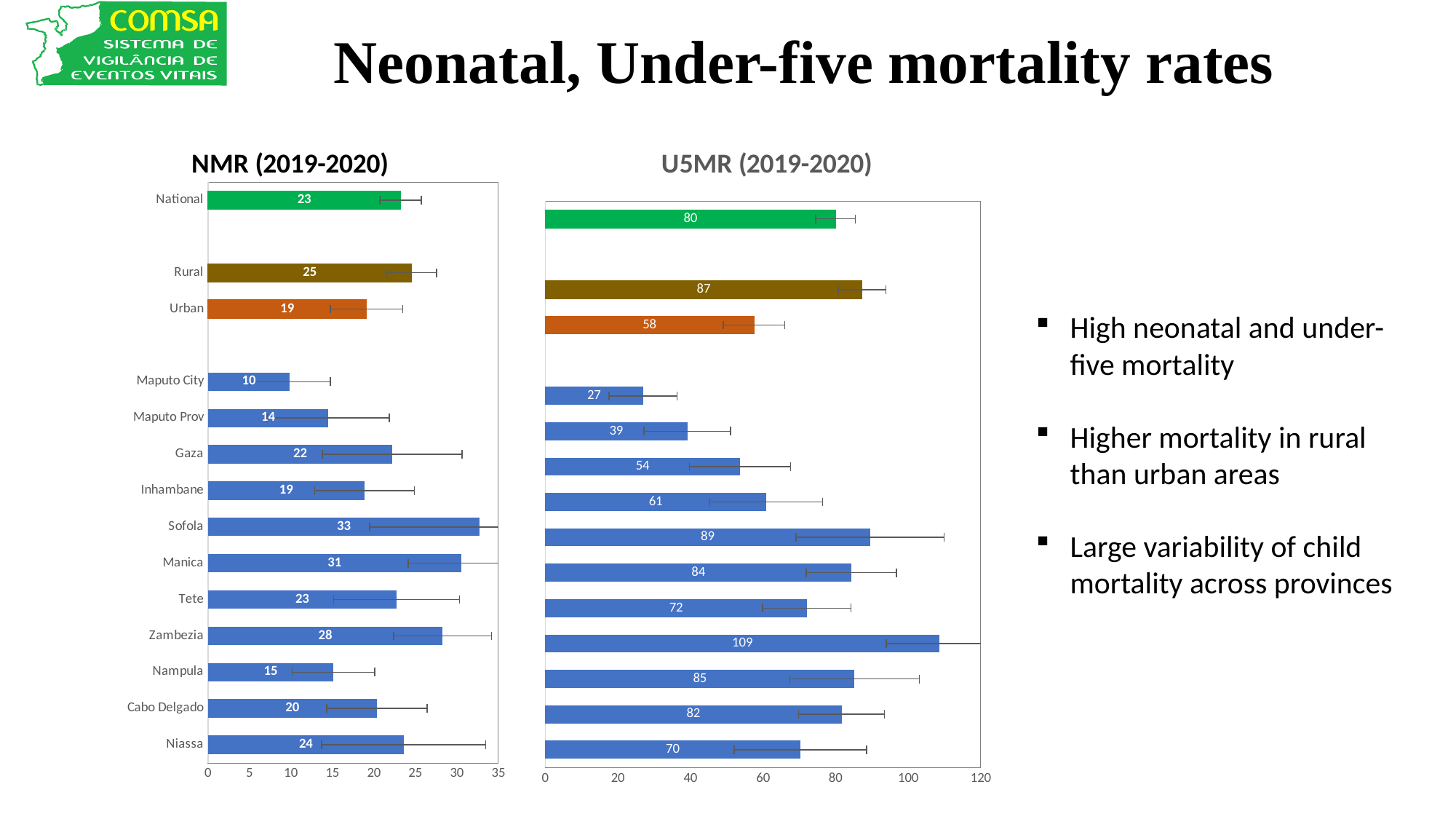
In the NMR (2019-2020) chart, which is larger, the value for Zambezia or the value for Nampula? Zambezia In the NMR (2019-2020) chart, which province has the highest value? Sofola What kind of chart is the U5MR (2019-2020) chart? Bar chart In the NMR (2019-2020) chart, what is the National value? 23 In the NMR (2019-2020) chart, what is the difference between the Rural and Urban values? 6 In the U5MR (2019-2020) chart, what is the highest value shown on any bar? 109 In the U5MR (2019-2020) chart, what is the value of the top (green) bar? 80 In the NMR (2019-2020) chart, what is the value for Sofala? 33 In the U5MR (2019-2020) chart, what is the difference between the Rural (brown) bar and the Urban (orange) bar? 29 In the NMR (2019-2020) chart, which province has the lowest value? Maputo City In the NMR (2019-2020) chart, what is the value for Maputo City? 10 In the NMR (2019-2020) chart, how many provinces are listed (excluding National, Rural and Urban)? 11